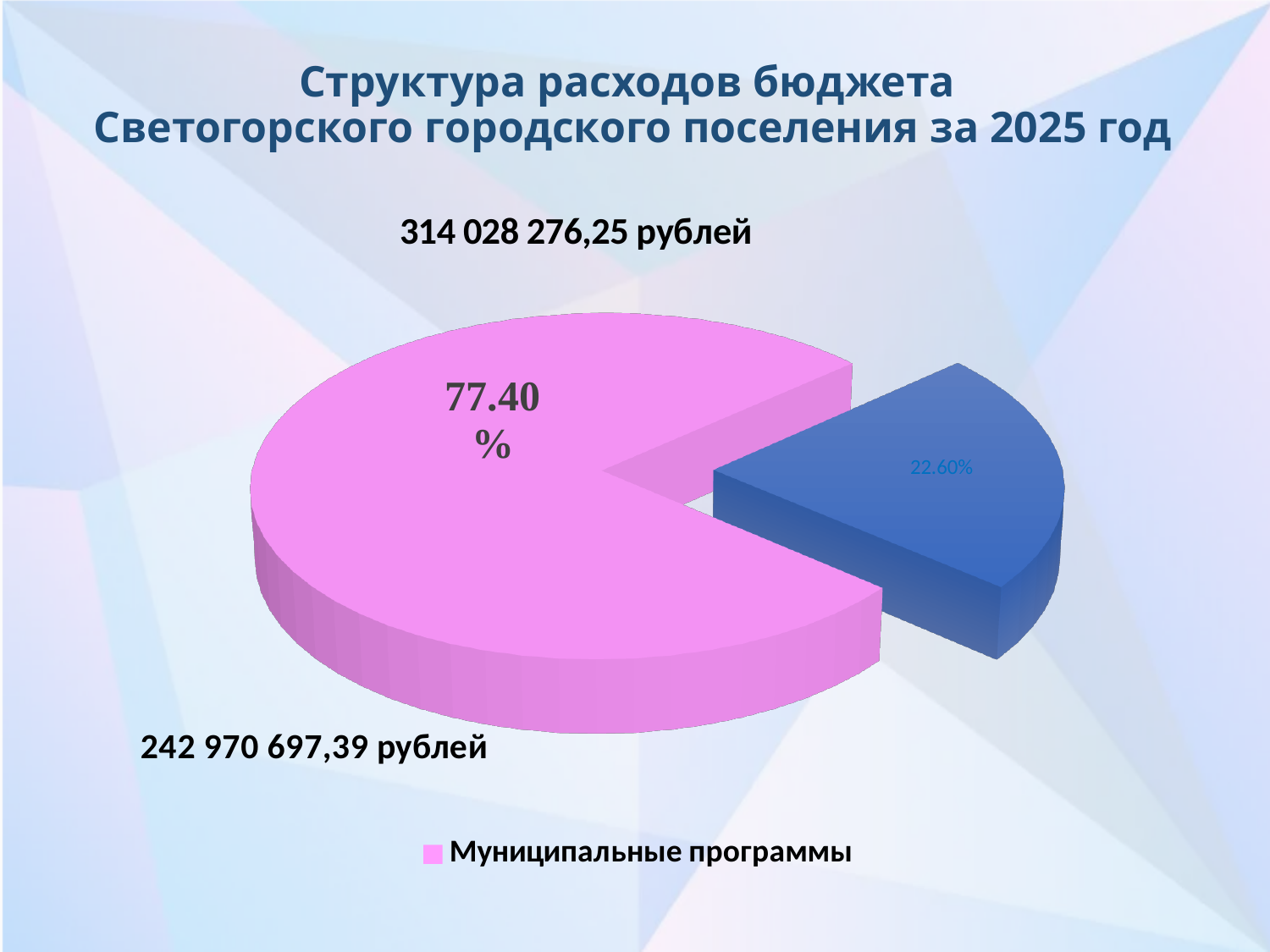
What colour is the Муниципальные программы slice? pink Which slice is the smallest in the pie chart? the blue slice (22.60%) Which slice is the largest in the pie chart? Муниципальные программы How many entries does the legend list? 1 What amount in rubles is printed above the pie chart? 314 028 276,25 рублей What kind of chart is shown on the slide? pie chart Is the share of the Муниципальные программы slice greater or less than 50%? greater How many slices does the pie chart have? 2 What share of the pie does the blue slice represent? 22.60% Which is larger: the Муниципальные программы slice or the blue slice? Муниципальные программы By how many percentage points does the Муниципальные программы slice exceed the blue slice? 54.80 What share of the pie does the Муниципальные программы slice represent? 77.40%